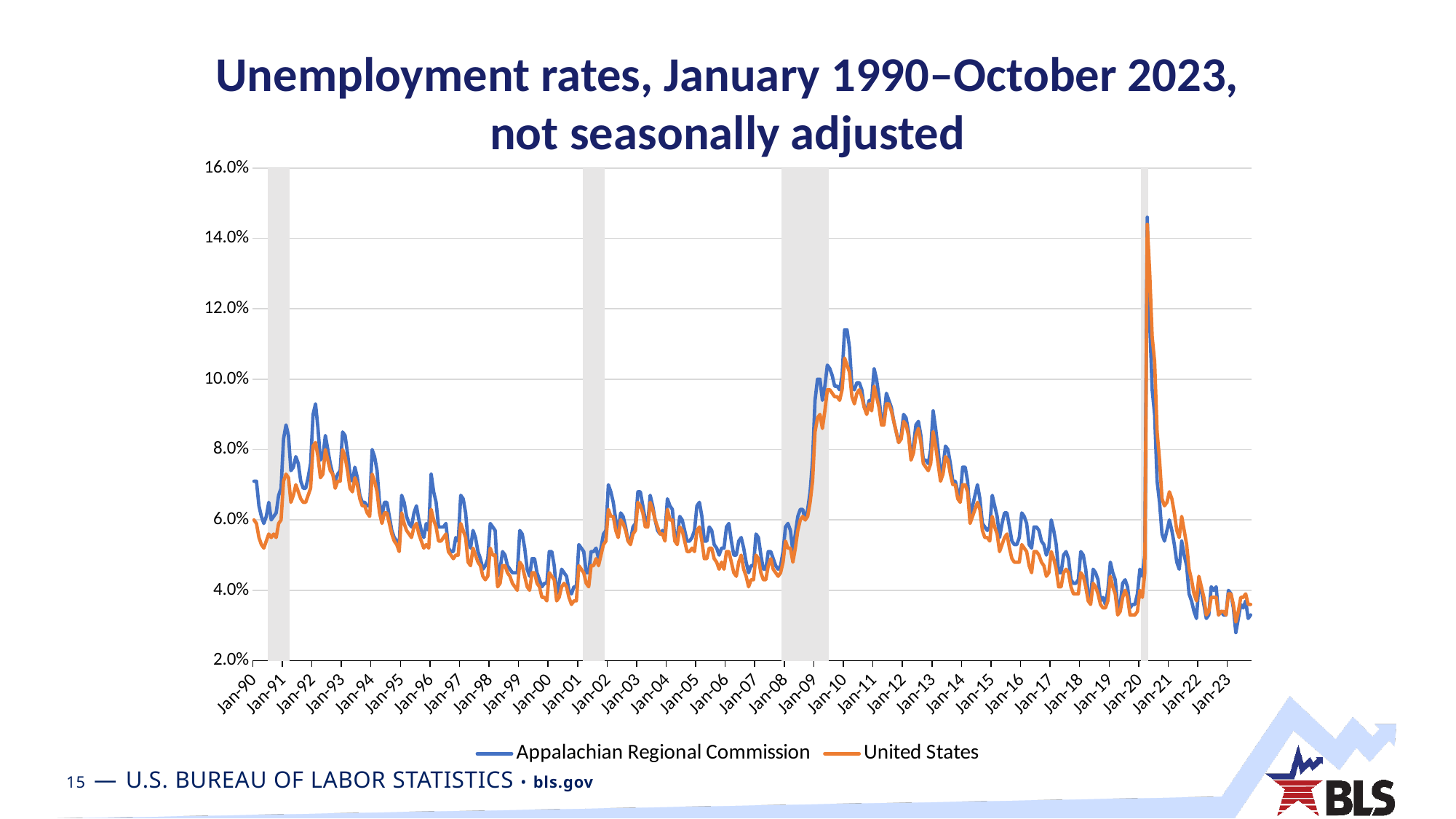
Between Jan-08 and Jan-10, do the unemployment rates rise or fall? rise Which series reaches the highest point on the chart, at its 2020 spike? Appalachian Regional Commission Between Jan-10 and Jan-20, do the unemployment rates generally rise or fall? fall Around Jan-10, is the Appalachian Regional Commission unemployment rate greater or less than 10.0%? greater What is the title of the chart? Unemployment rates, January 1990–October 2023, not seasonally adjusted What kind of chart is shown on the slide? Line chart Around Jan-00, is the United States unemployment rate greater or less than 6.0%? less Which colour is used for the United States line? Orange How many series does the legend list? 2 At Jan-90, which series has the higher unemployment rate? Appalachian Regional Commission Is the peak value of the United States line in 2020 greater or less than 12.0%? greater